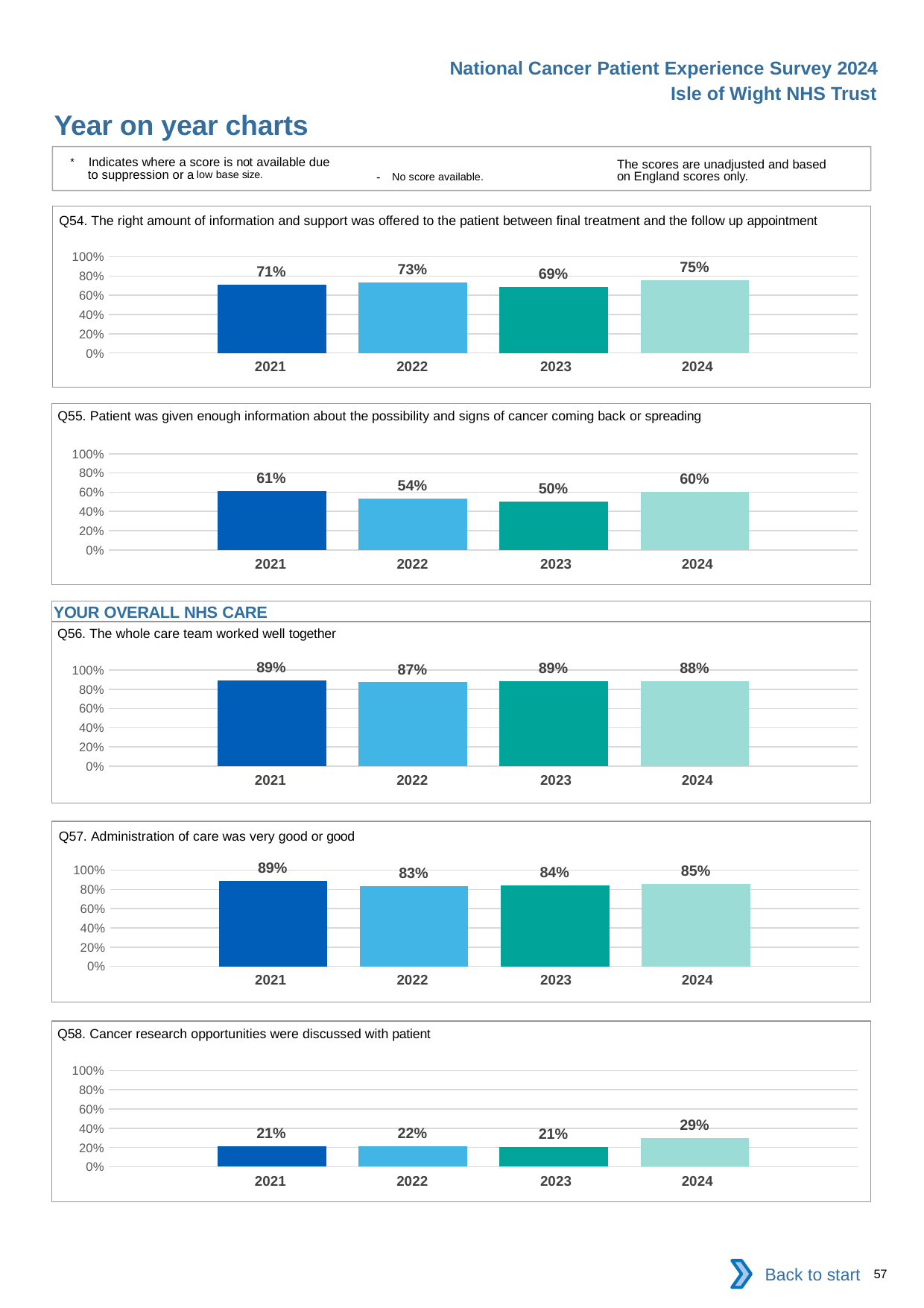
In the Q57 chart, which is larger, the value for 2021 or the value for 2024? 2021 In the Q56 chart, what is the value for 2022? 87% How many years are shown on the x axis of the Q58 chart? 4 In the Q55 chart, which year has the highest value? 2021 In the Q58 chart, what is the value for 2024? 29% In the Q54 chart, which year has the lowest value? 2023 What kind of chart is the Q56 chart? Bar chart In the Q54 chart, what is the value for 2024? 75% In the Q57 chart, what is the difference between the 2021 and 2022 values? 6 percentage points In the Q55 chart, what is the difference between the 2021 and 2023 values? 11 percentage points In the Q58 chart, is the value for 2023 greater or less than 40%? less In the Q55 chart, what is the value for 2022? 54%